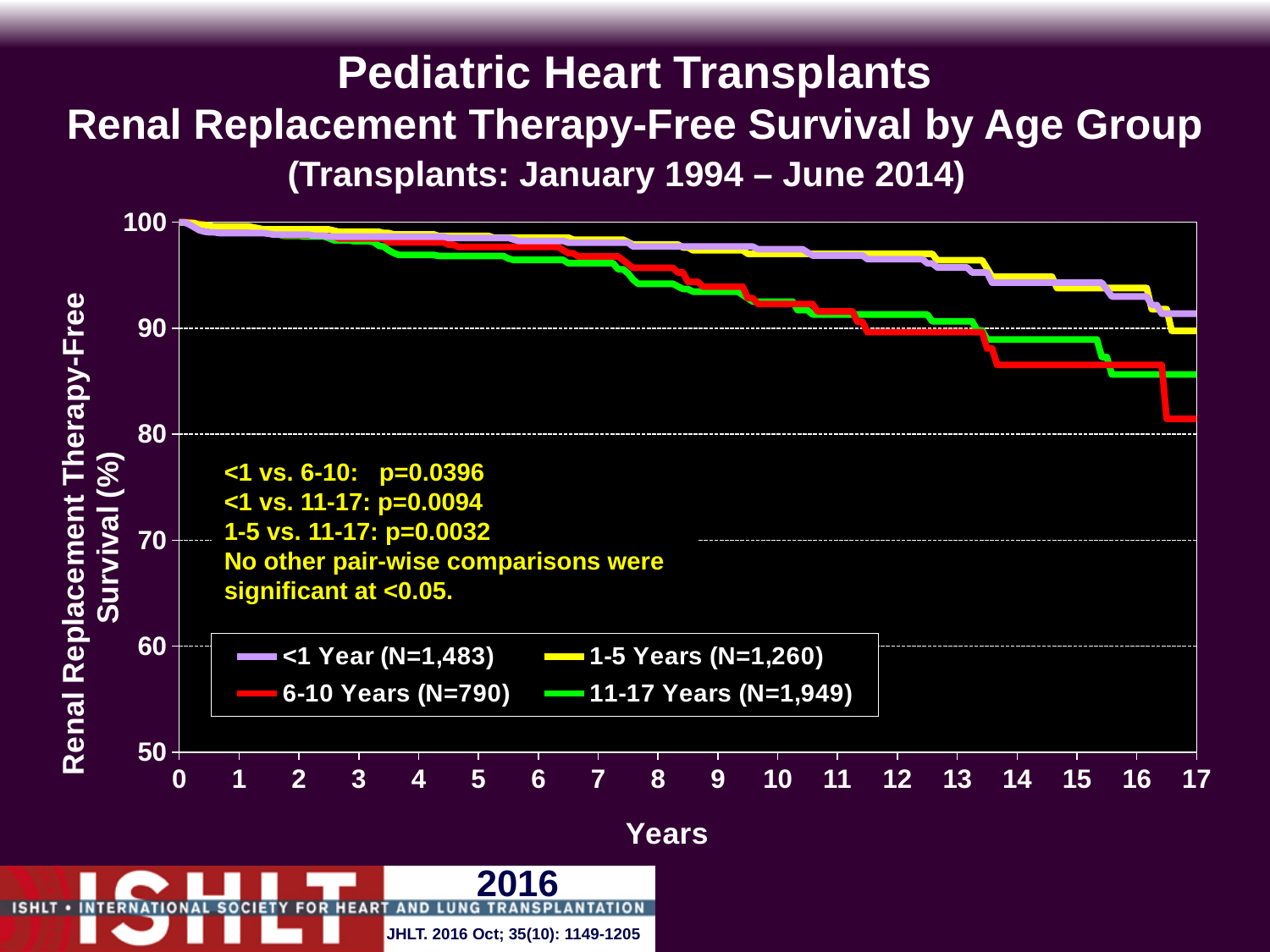
Is the value for <1 Year at 14 years greater or less than 90? greater According to the legend, what is the N for the 11-17 Years group? N=1,949 How many series does the legend list? 4 Which age group has the lowest renal replacement therapy-free survival at 17 years? 6-10 Years Is the value for 11-17 Years at 17 years greater or less than 80? greater Do the survival curves rise or fall as the years increase? fall At 17 years, which is higher: the <1 Year curve or the 6-10 Years curve? <1 Year Is the value for 6-10 Years at 10 years greater or less than 90? greater What is the label of the x axis? Years What kind of chart is shown on the slide? line chart At 17 years, which is higher: the 11-17 Years curve or the 6-10 Years curve? 11-17 Years